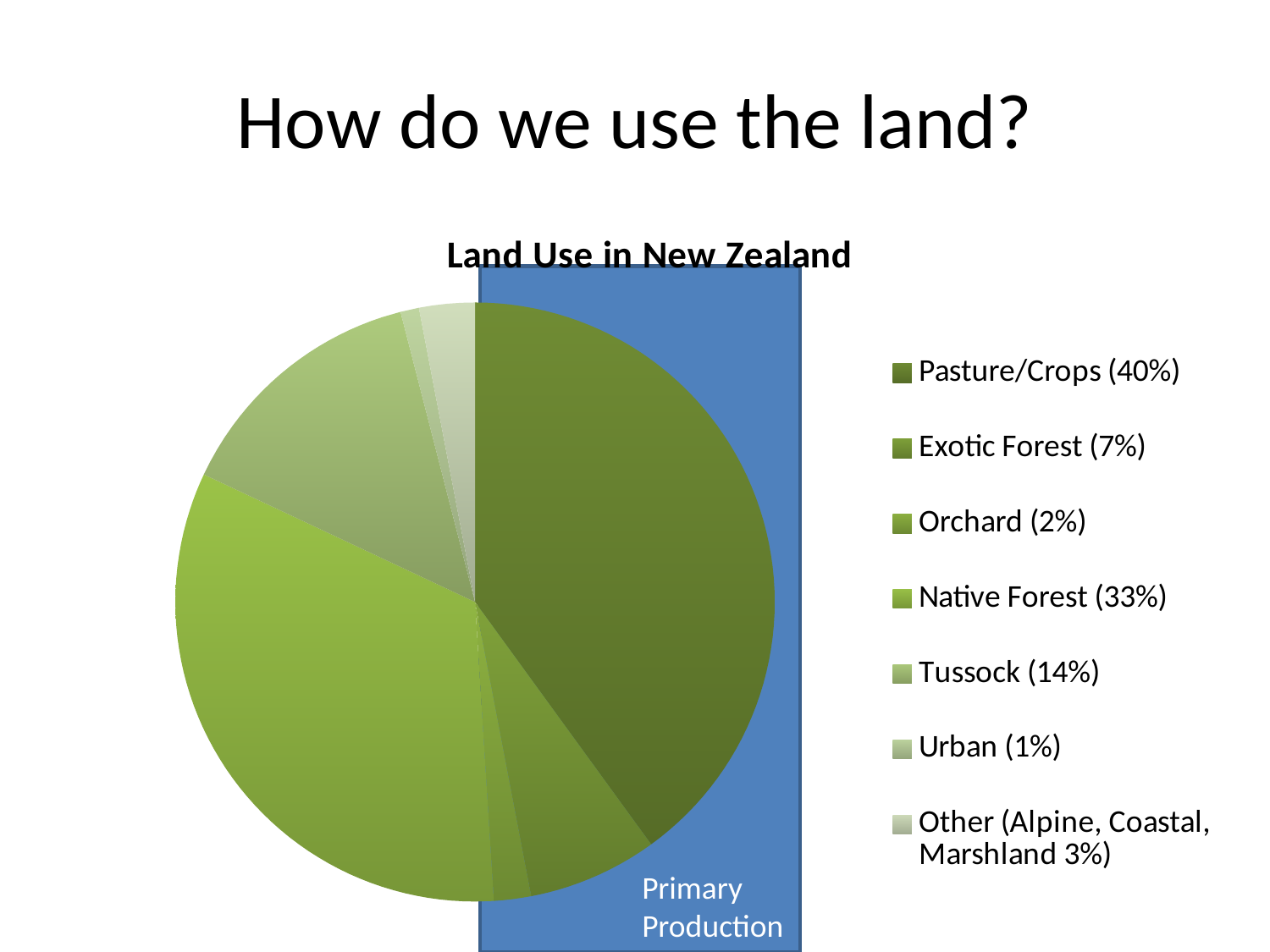
What share of land use is Pasture/Crops? 40% What share of land use is Native Forest? 33% What kind of chart is shown on the slide? pie chart What label appears in the blue box overlapping the right side of the pie? Primary Production Which category has the largest share of the pie? Pasture/Crops Which is larger, the share for Tussock or the share for Exotic Forest? Tussock Which category has the smallest share of the pie? Urban What share of land use is Exotic Forest? 7% How many categories does the pie chart's legend list? 7 What is the title of the chart? Land Use in New Zealand What is the difference in percentage points between Pasture/Crops and Native Forest? 7